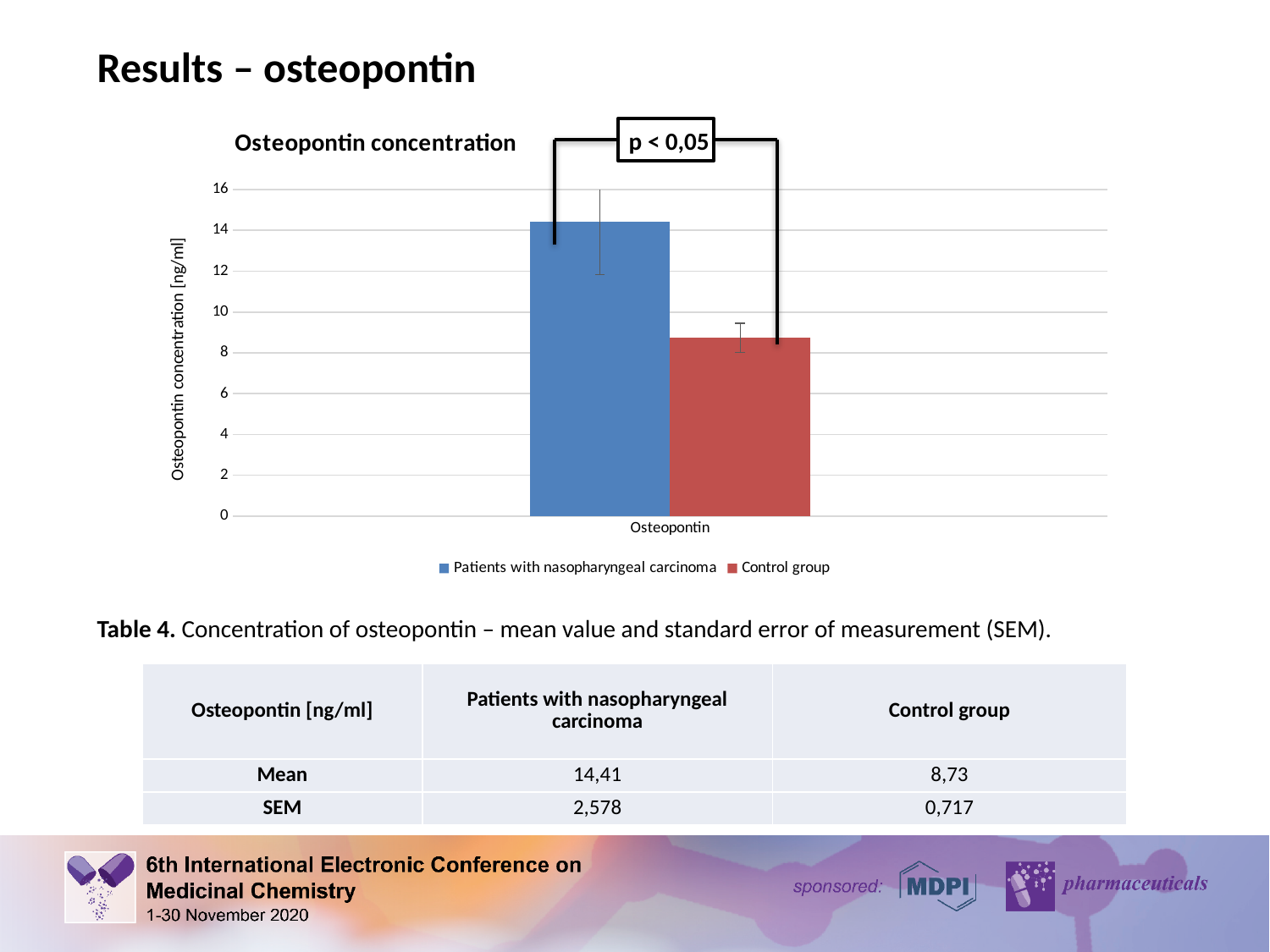
Which group has the lowest osteopontin concentration in the chart? Control group According to the slide, what is the mean osteopontin concentration for the control group? 8,73 What is the label on the vertical axis of the chart? Osteopontin concentration [ng/ml] What is the title of the chart? Osteopontin concentration What is the difference between the mean osteopontin concentration of patients with nasopharyngeal carcinoma and the control group? 5,68 How many categories are shown on the x axis of the chart? 1 Is the value for the control group greater or less than 10? less What kind of chart is shown on the slide? bar chart Is the value for patients with nasopharyngeal carcinoma greater or less than 14? greater How many series does the chart legend list? 2 Which series has the higher osteopontin concentration, patients with nasopharyngeal carcinoma or the control group? Patients with nasopharyngeal carcinoma According to the slide, what is the mean osteopontin concentration for patients with nasopharyngeal carcinoma? 14,41